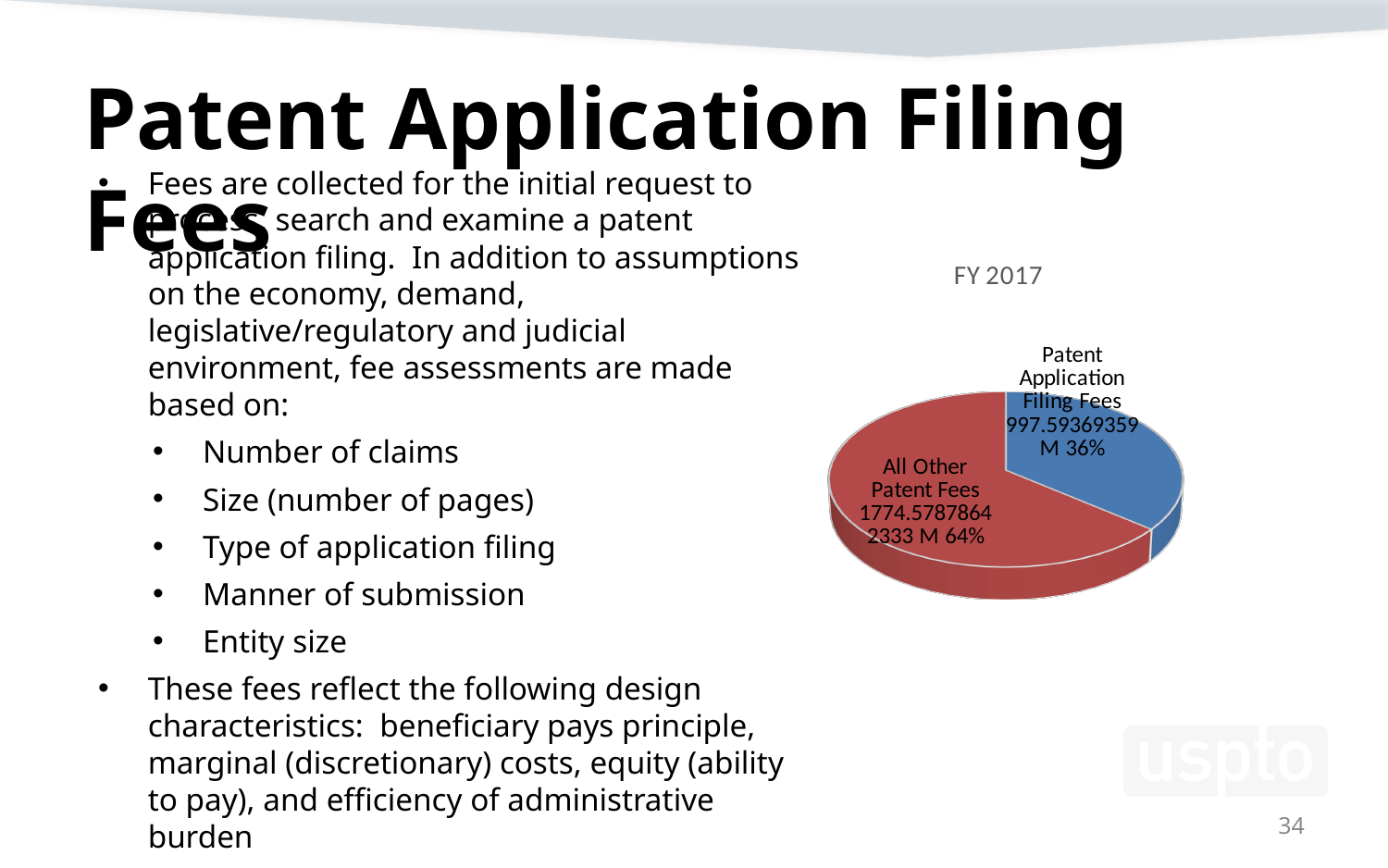
Which slice of the pie chart is the smallest? Patent Application Filing Fees What is the title of the pie chart? FY 2017 What kind of chart is shown on the slide? pie chart How many slices does the pie chart have? 2 Which is larger, Patent Application Filing Fees or All Other Patent Fees? All Other Patent Fees What share of the pie is Patent Application Filing Fees? 36% What colour is the All Other Patent Fees slice? red Which slice of the pie chart is the largest? All Other Patent Fees By how many percentage points does the All Other Patent Fees share exceed the Patent Application Filing Fees share? 28 percentage points What value is printed for Patent Application Filing Fees in the pie chart? 997.59369359 M What share of the pie is All Other Patent Fees? 64%